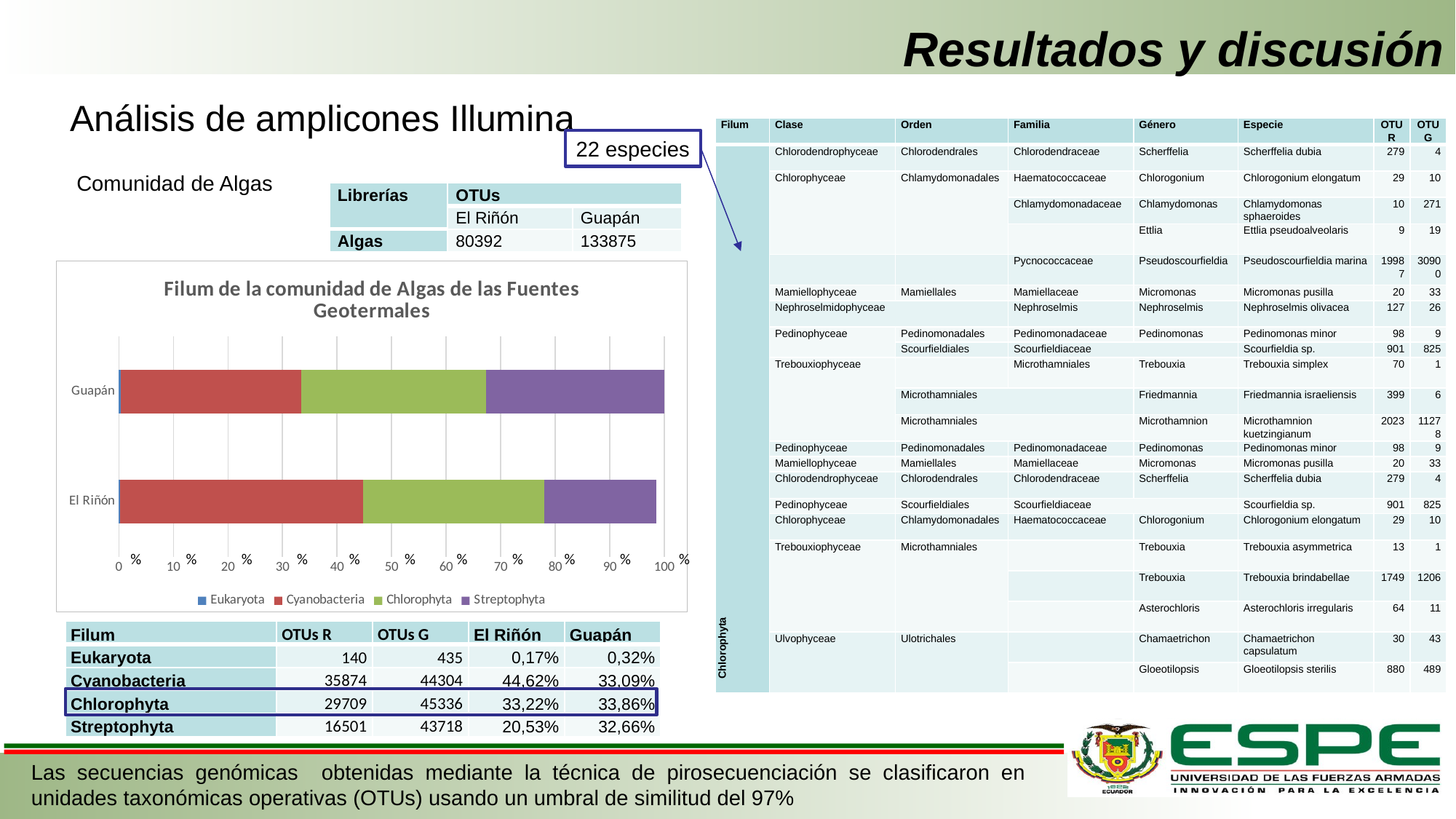
In the chart, which library has the larger Streptophyta share, El Riñón or Guapán? Guapán How many series does the chart legend list? 4 In the chart, is the Cyanobacteria share for El Riñón greater or less than 40%? greater Which series is shown in red in the chart? Cyanobacteria In the chart, which library has the larger Cyanobacteria share, El Riñón or Guapán? El Riñón How many categories (libraries) are plotted on the chart's vertical axis? 2 In the chart, is the Streptophyta share for El Riñón greater or less than 30%? less According to the table below the chart, what is the Streptophyta percentage for Guapán? 32,66% What kind of chart is shown on the slide? Stacked bar chart What is the title of the chart on the slide? Filum de la comunidad de Algas de las Fuentes Geotermales According to the table below the chart, what is the Cyanobacteria percentage for El Riñón? 44,62% In the chart, which phylum has the largest segment in the El Riñón bar? Cyanobacteria